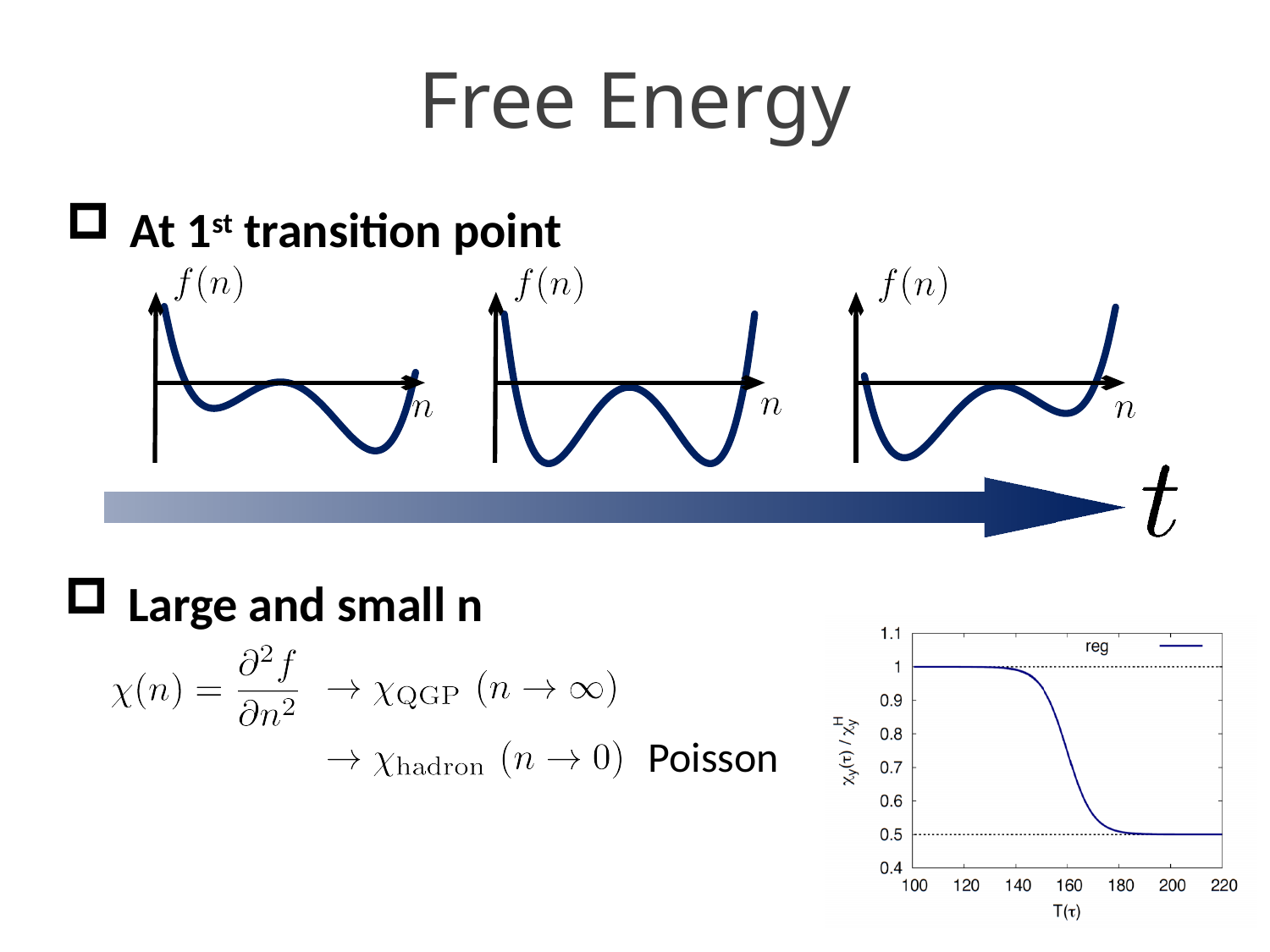
In the bottom-right chart, is the value of the line at T(τ) = 160 greater or less than 0.9? less In the bottom-right chart, is the value of the line at T(τ) = 200 greater or less than 0.6? less In the bottom-right chart, how many series does the legend list? 1 In the bottom-right chart, is the value of the line at T(τ) = 160 greater or less than 0.6? greater In the bottom-right chart, what is the legend entry for the plotted line? reg In the bottom-right chart, what is the value of the line at T(τ) = 100? 1 What kind of chart is shown at the bottom right of the slide? line chart In the bottom-right chart, what is the value of the line at T(τ) = 220? 0.5 In the bottom-right chart, what is the label of the x axis? T(τ) In the bottom-right chart, does the plotted value rise or fall as T(τ) increases from 100 to 220? fall In the bottom-right chart, which is larger: the value of the line at T(τ) = 140 or at T(τ) = 180? T(τ) = 140